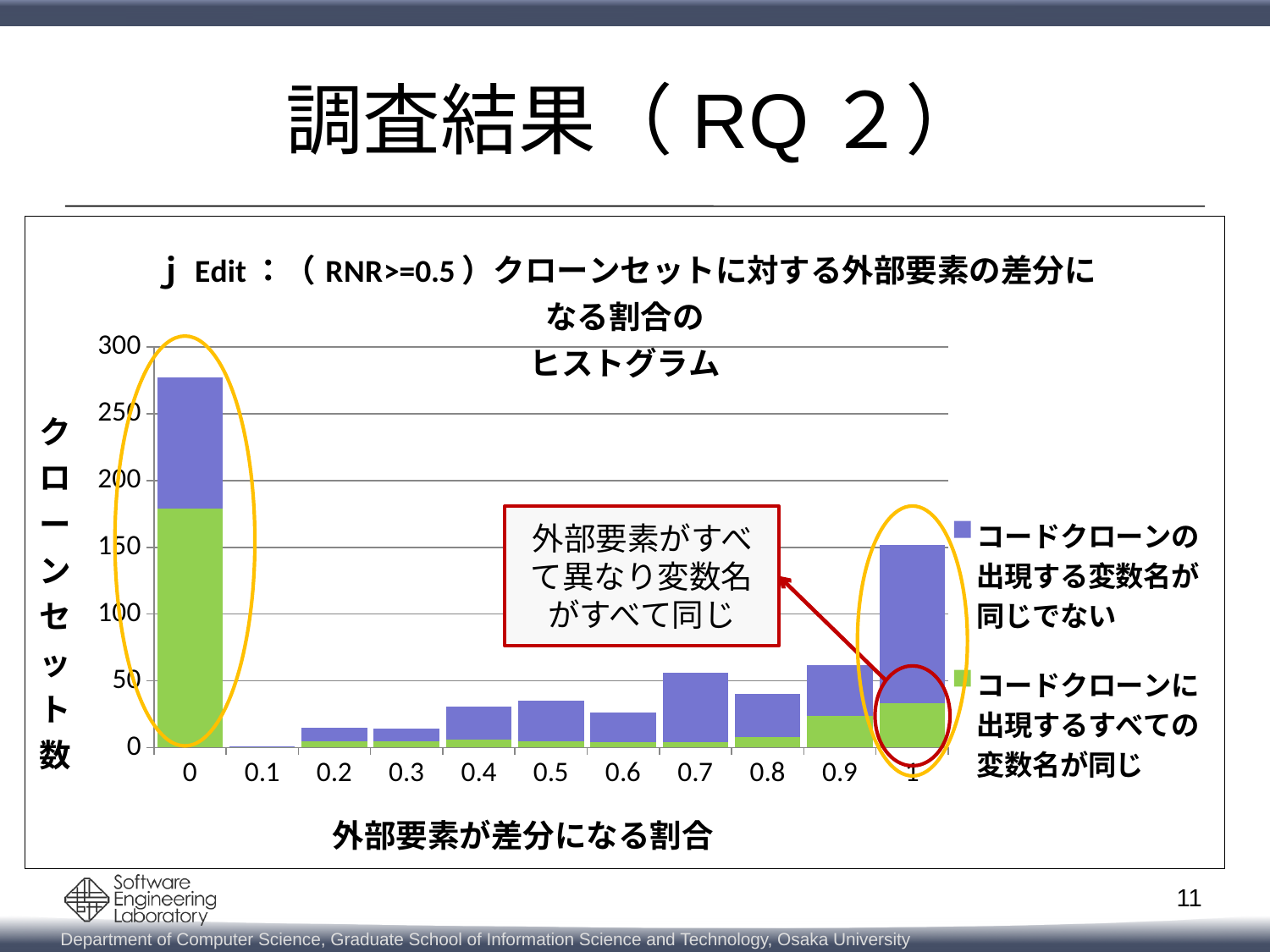
Which x-axis category has the lowest stacked bar? 0.1 Is the total stacked value for category 0 greater or less than 250? greater Is the total stacked value for category 1 greater or less than 200? less Which has the larger total stacked value, category 0.7 or category 0.6? 0.7 What kind of chart is shown on the slide? bar chart Is the total stacked value for category 0.5 greater or less than 50? less How many categories are shown on the x axis of the chart? 11 How many series does the chart's legend list? 2 Which has the larger total stacked value, category 0 or category 1? 0 Which x-axis category has the tallest stacked bar? 0 What is the title of the x axis of the chart? 外部要素が差分になる割合